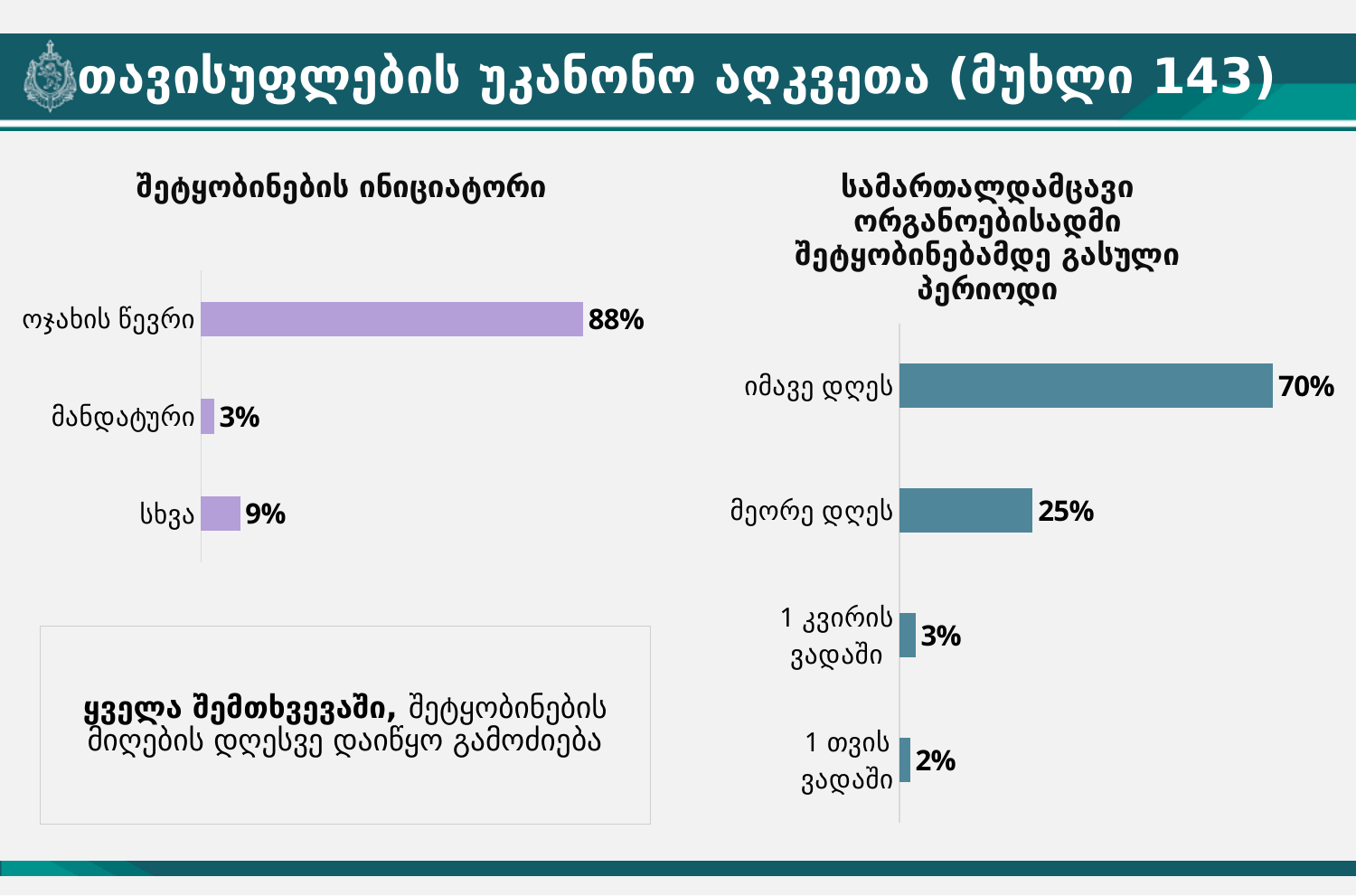
In the right chart (სამართალდამცავი ორგანოებისადმი შეტყობინებამდე გასული პერიოდი), which category has the lowest value? 1 თვის ვადაში In the left chart (შეტყობინების ინიციატორი), what is the difference between ოჯახის წევრი and სხვა? 79% In the left chart (შეტყობინების ინიციატორი), what is the value for ოჯახის წევრი? 88% In the right chart (სამართალდამცავი ორგანოებისადმი შეტყობინებამდე გასული პერიოდი), what is the value for 1 თვის ვადაში? 2% In the right chart (სამართალდამცავი ორგანოებისადმი შეტყობინებამდე გასული პერიოდი), how many categories are shown? 4 What type of chart is the right chart (სამართალდამცავი ორგანოებისადმი შეტყობინებამდე გასული პერიოდი)? Bar chart In the left chart (შეტყობინების ინიციატორი), which category has the highest value? ოჯახის წევრი In the left chart (შეტყობინების ინიციატორი), how many categories are shown? 3 In the right chart (სამართალდამცავი ორგანოებისადმი შეტყობინებამდე გასული პერიოდი), what is the difference between იმავე დღეს and მეორე დღეს? 45% In the left chart (შეტყობინების ინიციატორი), which category has the lowest value? მანდატური In the left chart (შეტყობინების ინიციატორი), what is the value for მანდატური? 3% In the right chart (სამართალდამცავი ორგანოებისადმი შეტყობინებამდე გასული პერიოდი), what is the value for იმავე დღეს? 70%